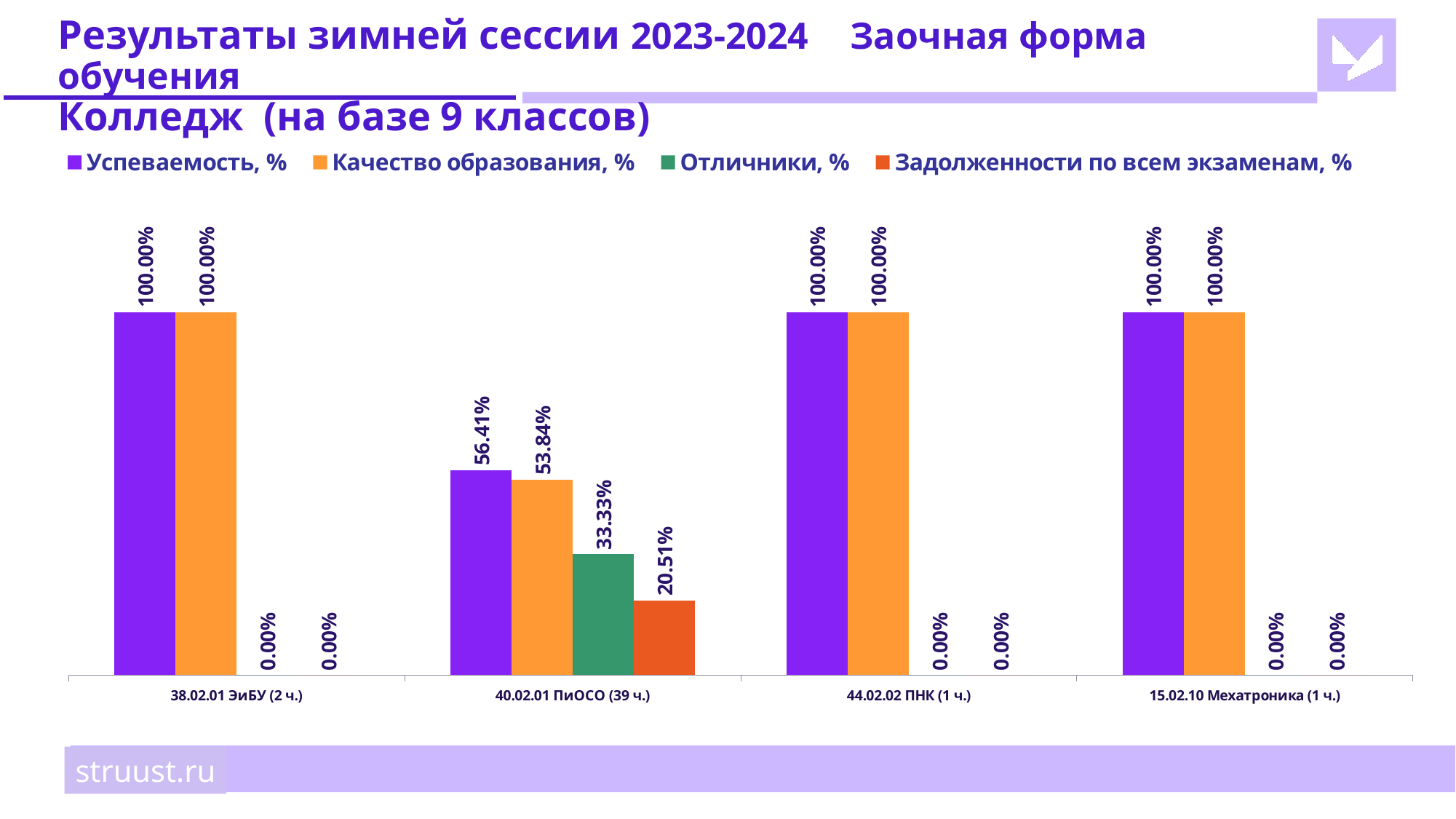
How many series does the legend list? 4 What is the value of Отличники, % for 40.02.01 ПиОСО (39 ч.)? 33.33% For 40.02.01 ПиОСО (39 ч.), which is larger: Отличники, % or Задолженности по всем экзаменам, %? Отличники, % What is the value of Качество образования, % for 40.02.01 ПиОСО (39 ч.)? 53.84% Which category has the highest value for Отличники, %? 40.02.01 ПиОСО (39 ч.) What is the value of Задолженности по всем экзаменам, % for 40.02.01 ПиОСО (39 ч.)? 20.51% Which category has the lowest value for Успеваемость, %? 40.02.01 ПиОСО (39 ч.) What is the value of Успеваемость, % for 40.02.01 ПиОСО (39 ч.)? 56.41% What is the value of Успеваемость, % for 44.02.02 ПНК (1 ч.)? 100.00% How many categories are shown on the x axis of the chart? 4 What is the difference between Успеваемость, % and Качество образования, % for 40.02.01 ПиОСО (39 ч.)? 2.57% What is the value of Отличники, % for 15.02.10 Мехатроника (1 ч.)? 0.00%